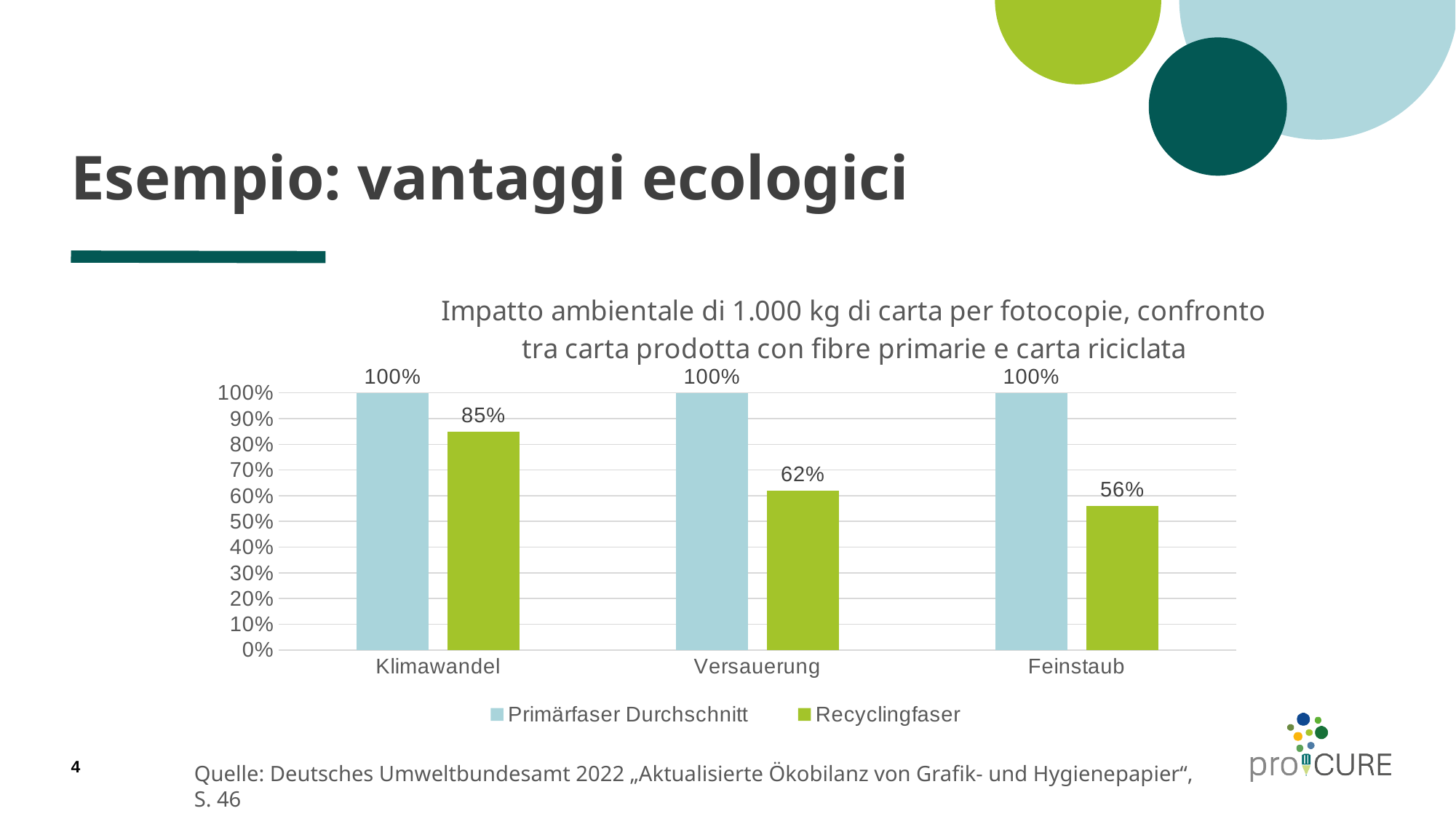
Which is larger in the Versauerung category: Primärfaser Durchschnitt or Recyclingfaser? Primärfaser Durchschnitt How many series does the legend list? 2 In which category is the Recyclingfaser value highest? Klimawandel What is the difference between Primärfaser Durchschnitt and Recyclingfaser in the Feinstaub category? 44% What kind of chart is shown on the slide? Bar chart What is the value for Recyclingfaser in the Klimawandel category? 85% What is the value for Recyclingfaser in the Feinstaub category? 56% What is the value for Primärfaser Durchschnitt in the Versauerung category? 100% What is the value for Recyclingfaser in the Versauerung category? 62% How many categories are shown on the x axis? 3 In which category is the Recyclingfaser value lowest? Feinstaub What is the difference between the Recyclingfaser values for Klimawandel and Versauerung? 23%